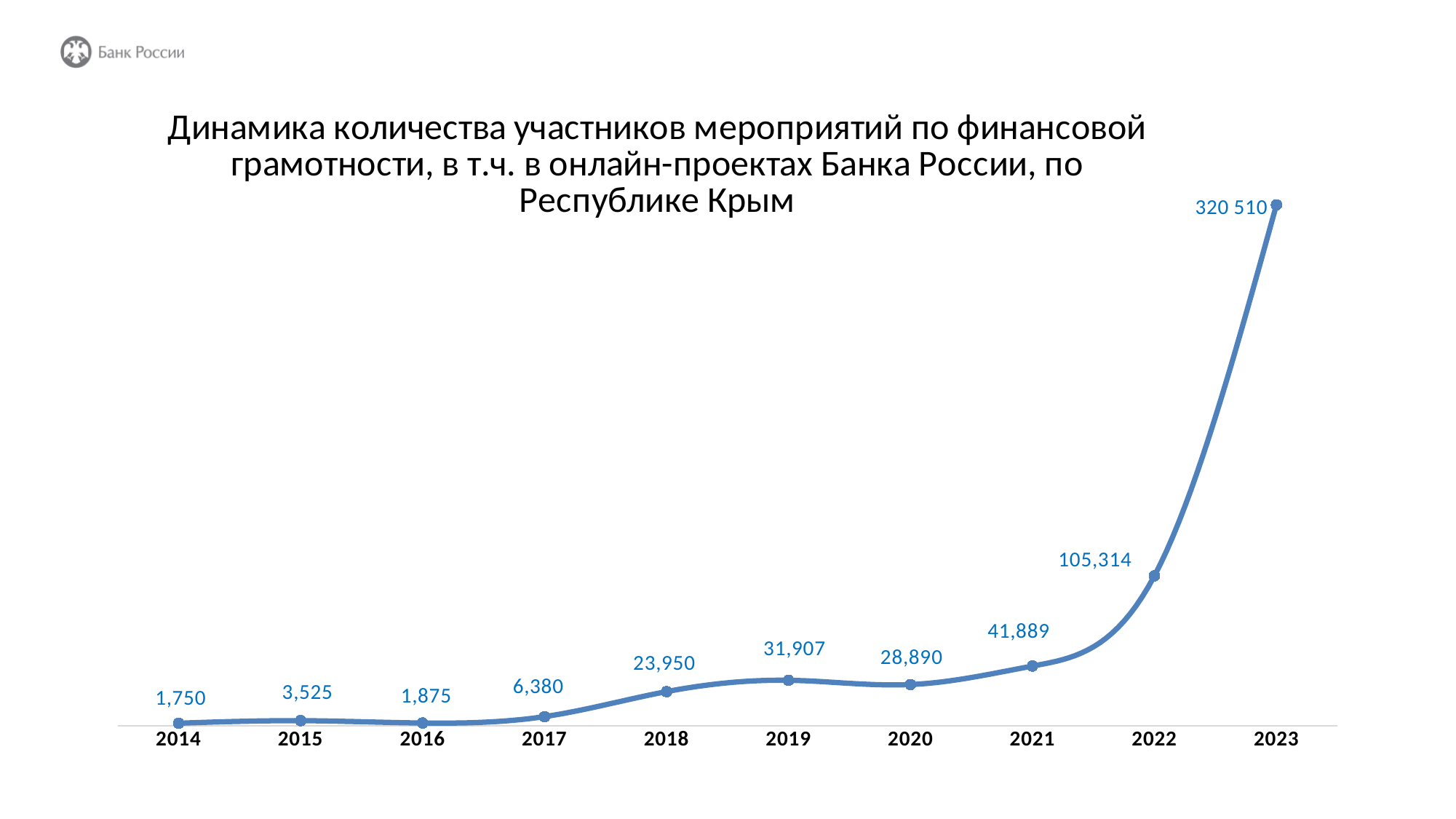
Which is larger, the value for 2015 or the value for 2016? 2015 Which year has the lowest value? 2014 What is the value for 2023? 320 510 What is the difference between the values for 2022 and 2021? 63,425 Which year has the highest value? 2023 Do the values generally rise or fall from 2017 to 2023? Rise What is the value for 2022? 105,314 How many years are plotted on the chart? 10 What kind of chart is shown on the slide? Line chart What is the value for 2014? 1,750 What is the value for 2019? 31,907 What is the difference between the values for 2019 and 2020? 3,017